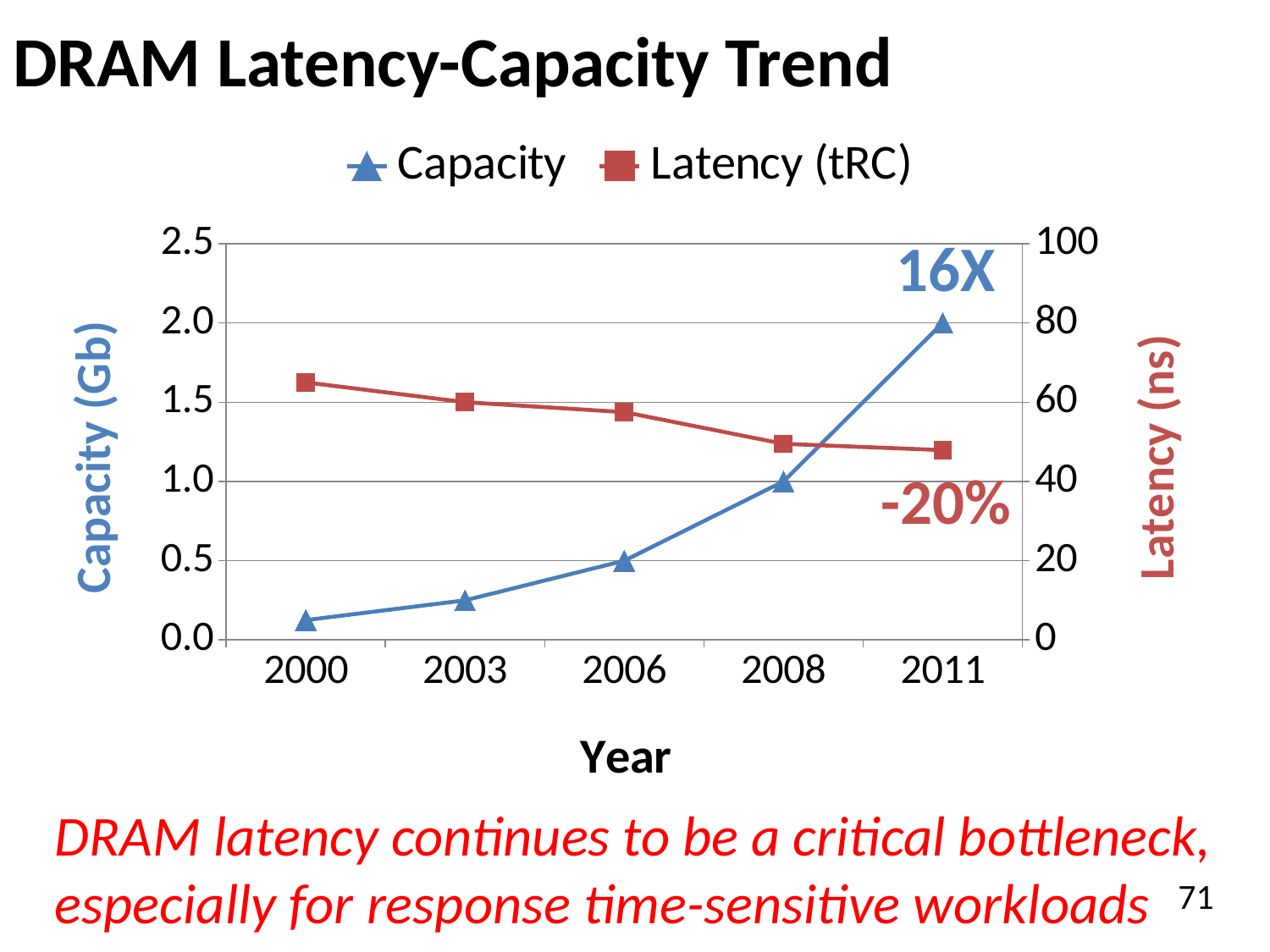
Is the Latency (tRC) value for 2000 greater or less than 60? greater Is the Capacity value for 2000 greater or less than 0.5? less What kind of chart is shown on the slide? line chart What is the difference between the Capacity values for 2011 and 2008? 1.0 What is the Capacity value for 2008? 1.0 How many series does the legend list? 2 In which year is Latency (tRC) highest? 2000 Does the Latency (tRC) series rise or fall from 2000 to 2011? fall What is the Capacity value for 2011? 2.0 How many years are plotted along the x axis? 5 In which year is Capacity highest? 2011 Does the Capacity series rise or fall from 2000 to 2011? rise